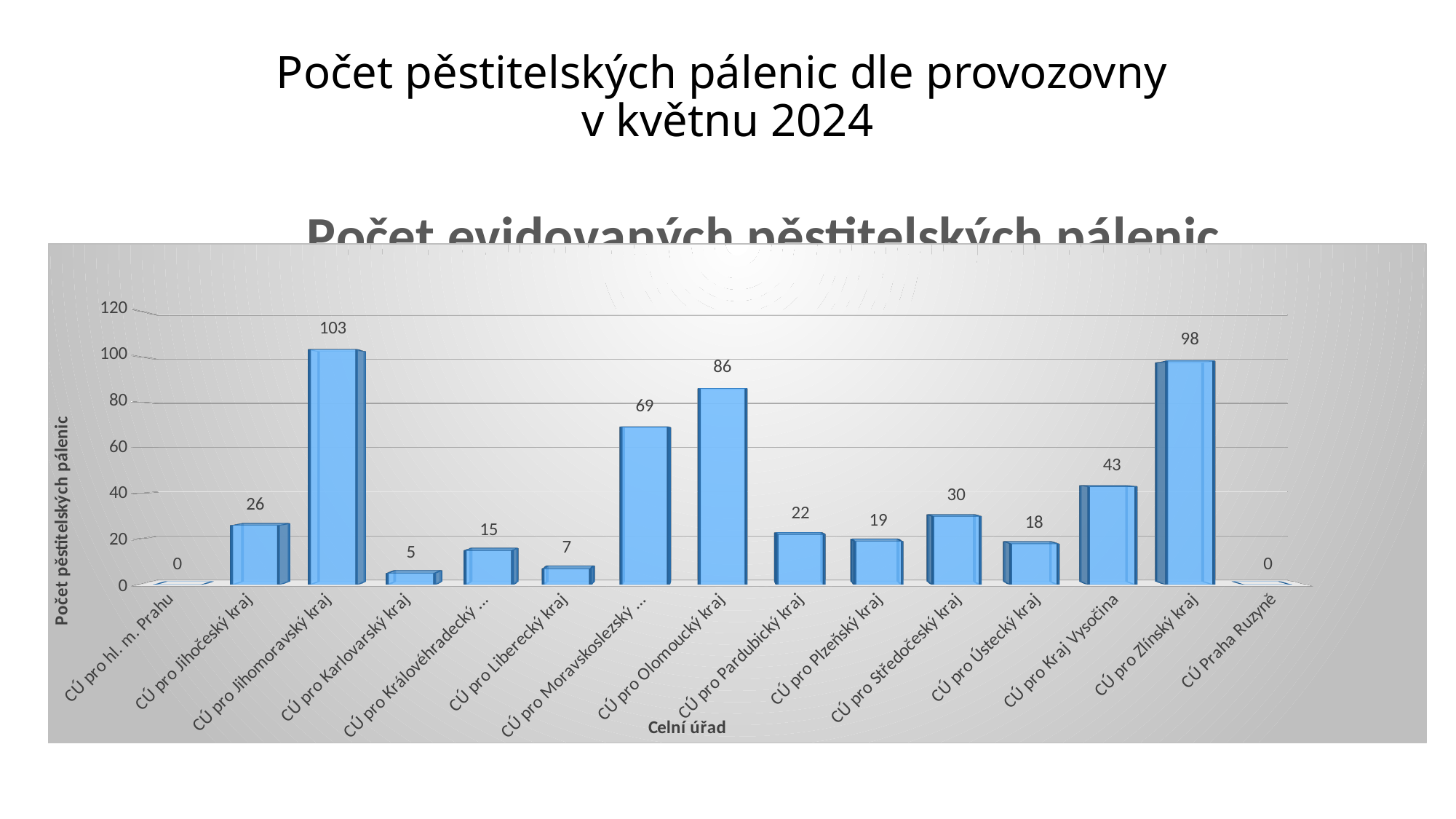
Which is larger, the value for CÚ pro Středočeský kraj or the value for CÚ pro Pardubický kraj? CÚ pro Středočeský kraj What is the value for CÚ pro Jihomoravský kraj? 103 What is the value for CÚ pro Olomoucký kraj? 86 What is the difference between the values for CÚ pro Olomoucký kraj and CÚ pro Moravskoslezský ...? 17 How many categories have a value of 0? 2 What is the value for CÚ pro Karlovarský kraj? 5 What is the title of the x axis? Celní úřad What is the value for CÚ pro Kraj Vysočina? 43 How many categories are shown on the x axis? 15 Which category has the highest value? CÚ pro Jihomoravský kraj What is the difference between the values for CÚ pro Jihomoravský kraj and CÚ pro Zlínský kraj? 5 What kind of chart is shown on the slide? Bar chart